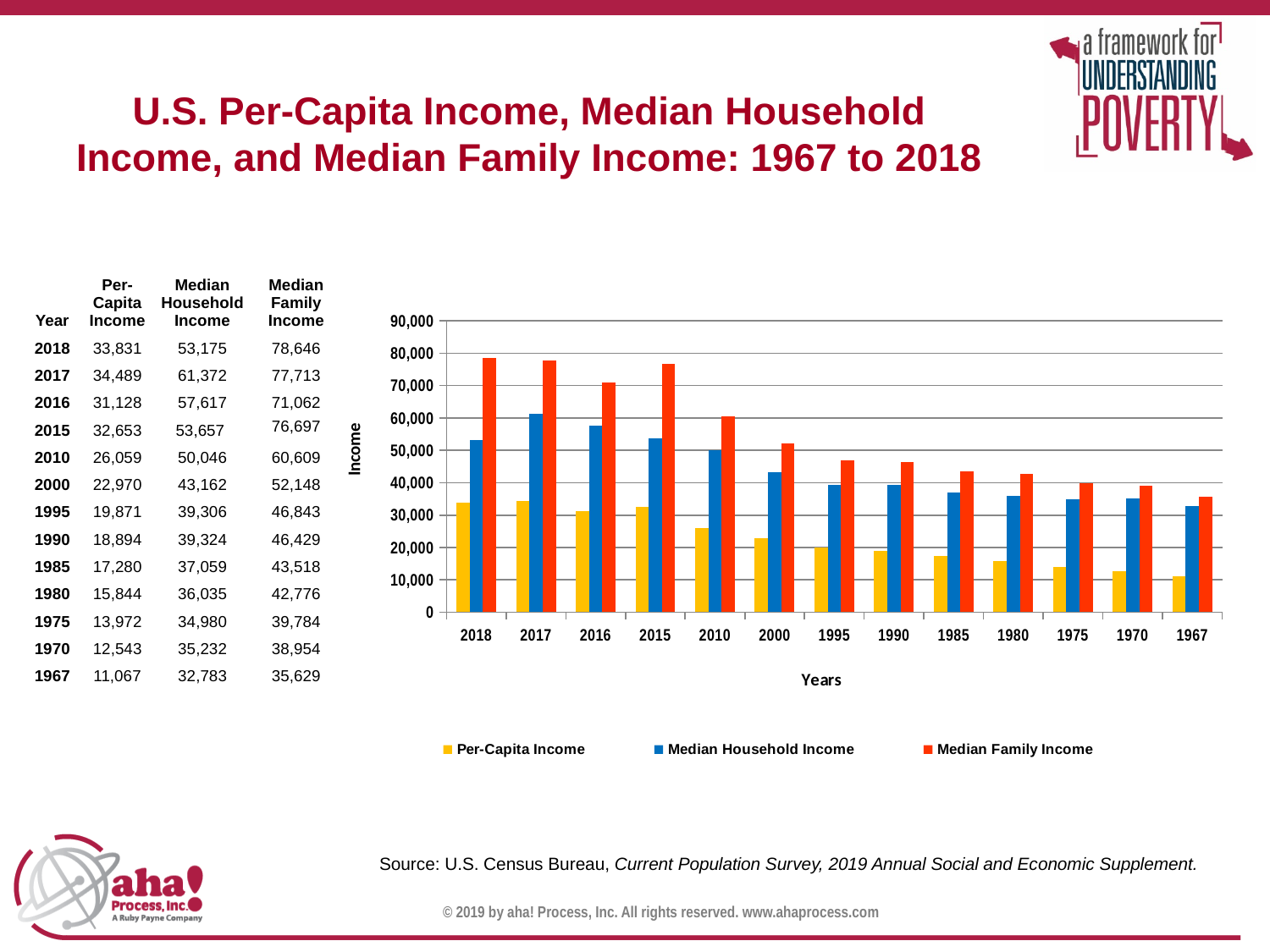
Is the Median Family Income for 2000 greater or less than 50,000? greater What is the Per-Capita Income for 1967? 11,067 Which year has the highest Median Household Income? 2017 What type of chart is shown on the slide? bar chart Which year has the lowest Per-Capita Income? 1967 How many years are shown on the x axis of the chart? 13 Which colour represents Median Family Income in the chart? red How many series does the chart legend list? 3 What is the difference between Median Family Income and Median Household Income in 2018? 25,471 What is the Median Household Income for 2017? 61,372 Which is larger in 2010: Median Household Income or Per-Capita Income? Median Household Income What is the Median Family Income for 2018? 78,646